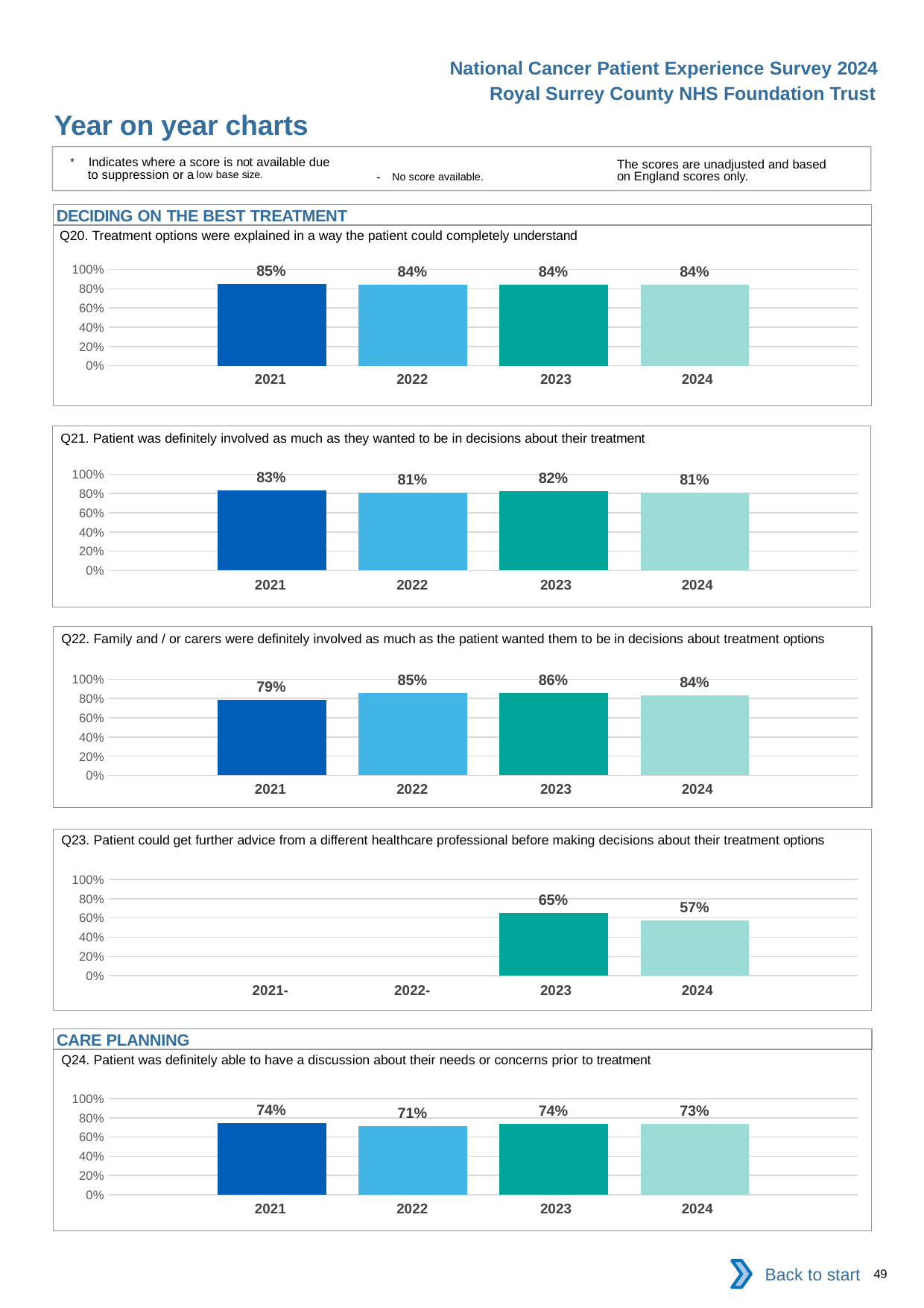
In the Q22 chart, how many years are shown on the x axis? 4 In the Q24 chart, what is the difference between the 2021 value and the 2022 value? 3 percentage points In the Q21 chart, is the value for 2024 greater or less than 60%? greater In the Q23 chart, how many years have a bar plotted? 2 In the Q24 chart, what is the value for 2022? 71% In the Q20 chart, what is the value for 2021? 85% In the Q22 chart, what is the difference between the 2023 value and the 2021 value? 7 percentage points In the Q21 chart, which year has the highest value? 2021 In the Q22 chart, which year has the lowest value? 2021 In the Q23 chart, which is larger, the value for 2023 or the value for 2024? 2023 In the Q23 chart, what is the value for 2024? 57% What kind of chart is the Q20 chart? Bar chart